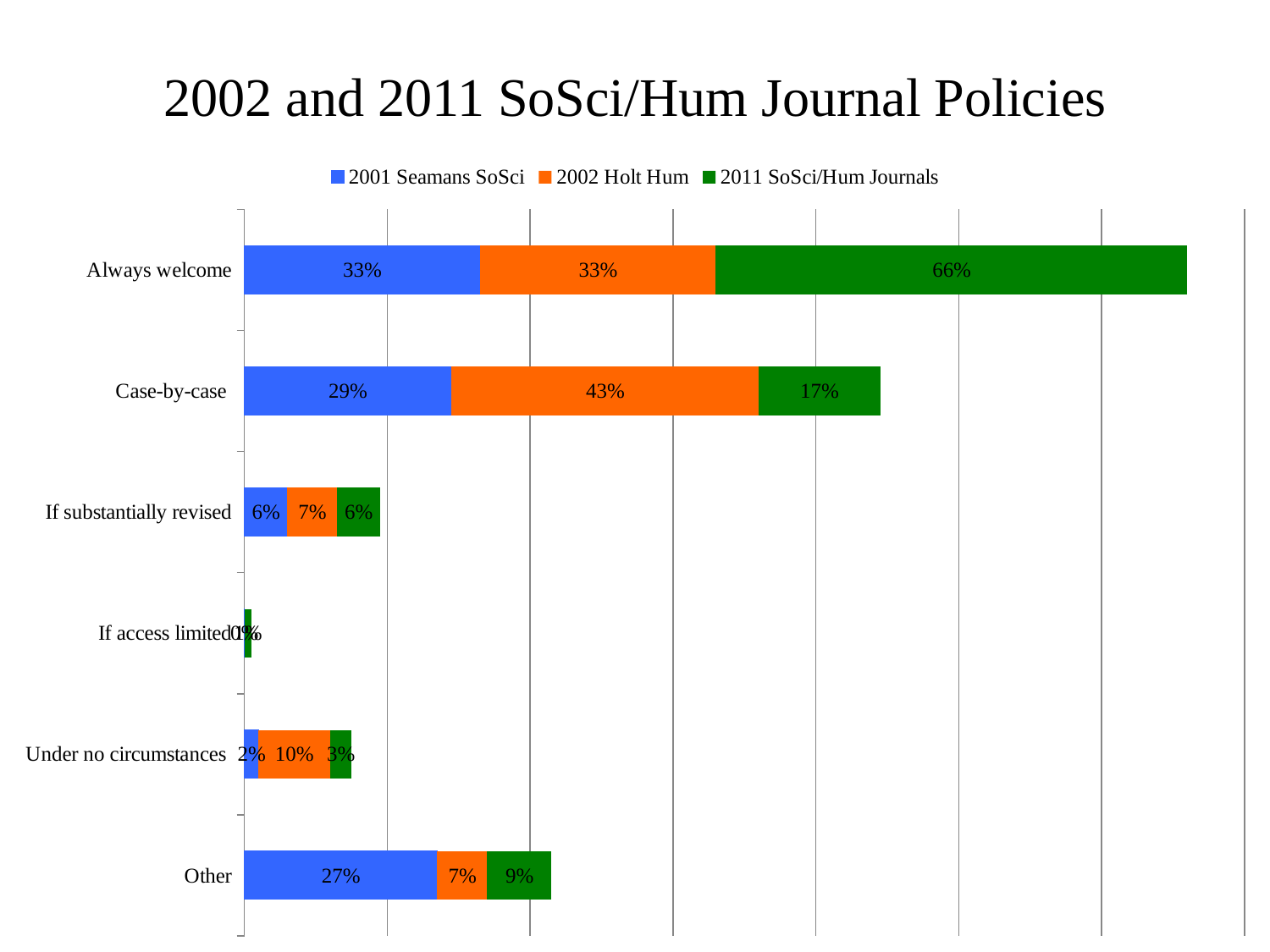
What is the value for 2001 Seamans SoSci in the Other category? 27% How many series does the legend list? 3 Which category has the highest value for 2011 SoSci/Hum Journals? Always welcome What kind of chart is shown on the slide? Stacked bar chart What is the value for 2002 Holt Hum in the Under no circumstances category? 10% What is the total of the stacked bar for the Other category? 43% What is the difference between the 2011 SoSci/Hum Journals value and the 2001 Seamans SoSci value in the Always welcome category? 33% Which is larger in the Case-by-case category: the 2002 Holt Hum value or the 2011 SoSci/Hum Journals value? 2002 Holt Hum What is the value for 2002 Holt Hum in the Case-by-case category? 43% How many categories are shown on the chart? 6 What is the value for 2011 SoSci/Hum Journals in the Always welcome category? 66%